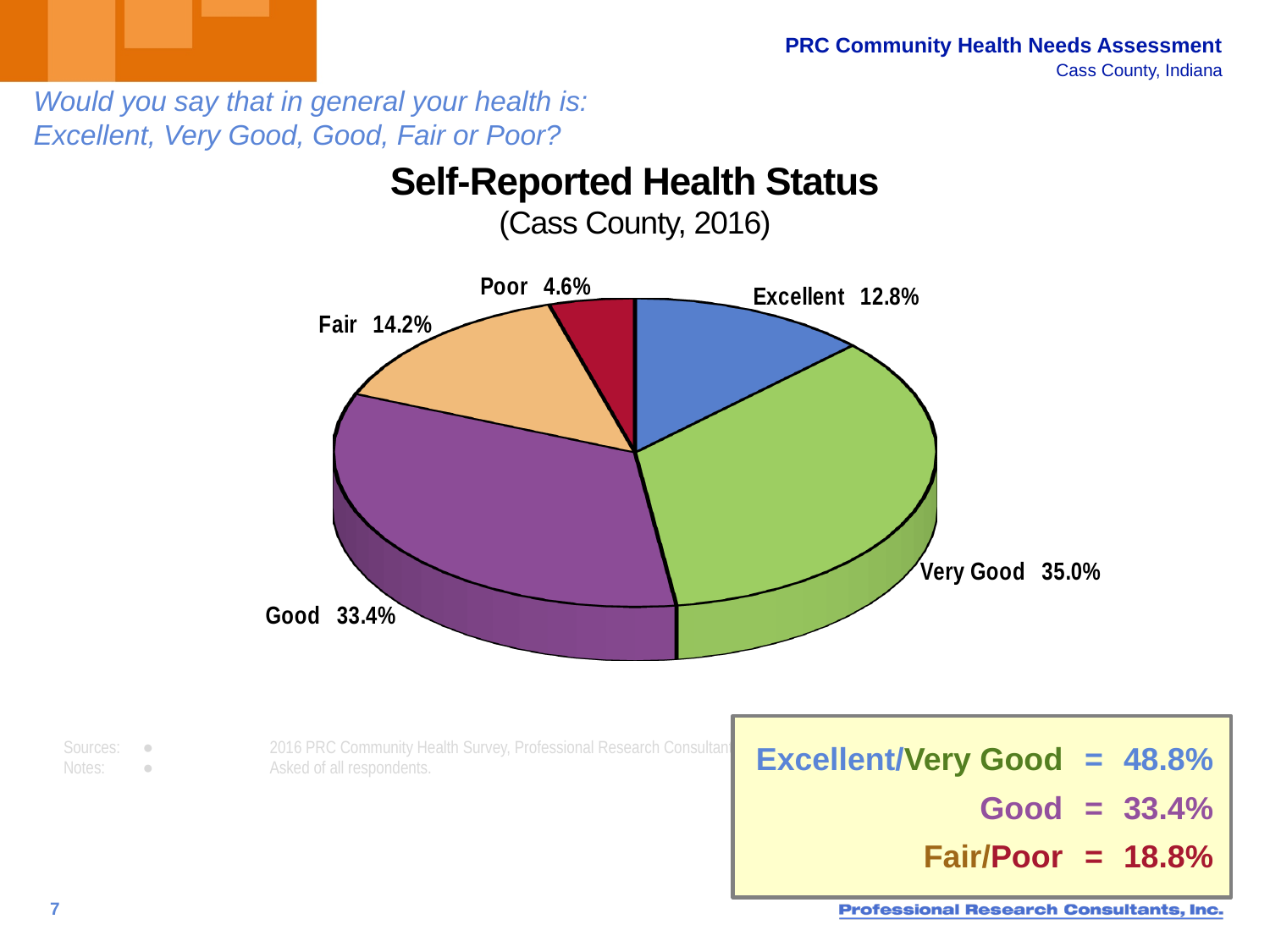
Which health status category has the largest share of the pie? Very Good What percentage of respondents reported their health as Very Good? 35.0% What is the difference in percentage points between the Very Good and Good slices? 1.6 What percentage of respondents reported their health as Excellent? 12.8% What is the combined share of the Excellent and Very Good slices? 48.8% Which is larger, the Fair slice or the Excellent slice? Fair What kind of chart is shown on the slide? Pie chart Which health status category has the smallest share of the pie? Poor How many categories are shown in the pie chart? 5 What is the title of the chart? Self-Reported Health Status What percentage of respondents reported their health as Fair? 14.2% What percentage of respondents reported their health as Poor? 4.6%